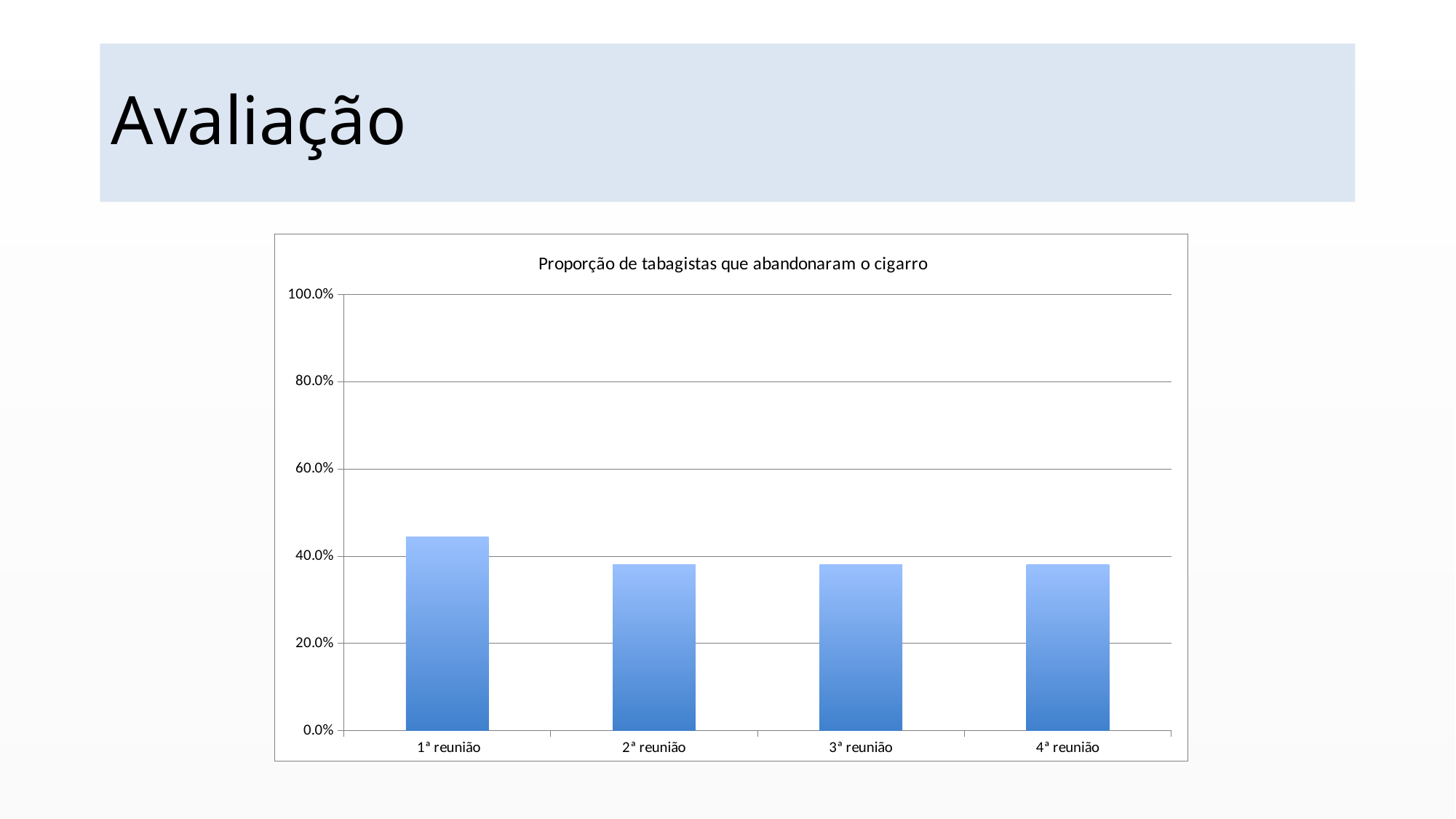
How many categories (reuniões) are plotted on the chart? 4 Which is larger, the value for 1ª reunião or the value for 2ª reunião? 1ª reunião What kind of chart is shown on the slide? bar chart Which reunião has the highest proportion of smokers who quit? 1ª reunião Is the value for 2ª reunião greater or less than 40.0%? less Does the value rise or fall from 1ª reunião to 2ª reunião? fall Is the value for 1ª reunião greater or less than 40.0%? greater Is the value for 3ª reunião greater or less than 20.0%? greater What is the title of the chart? Proporção de tabagistas que abandonaram o cigarro What is the highest value shown on the vertical axis? 100.0%